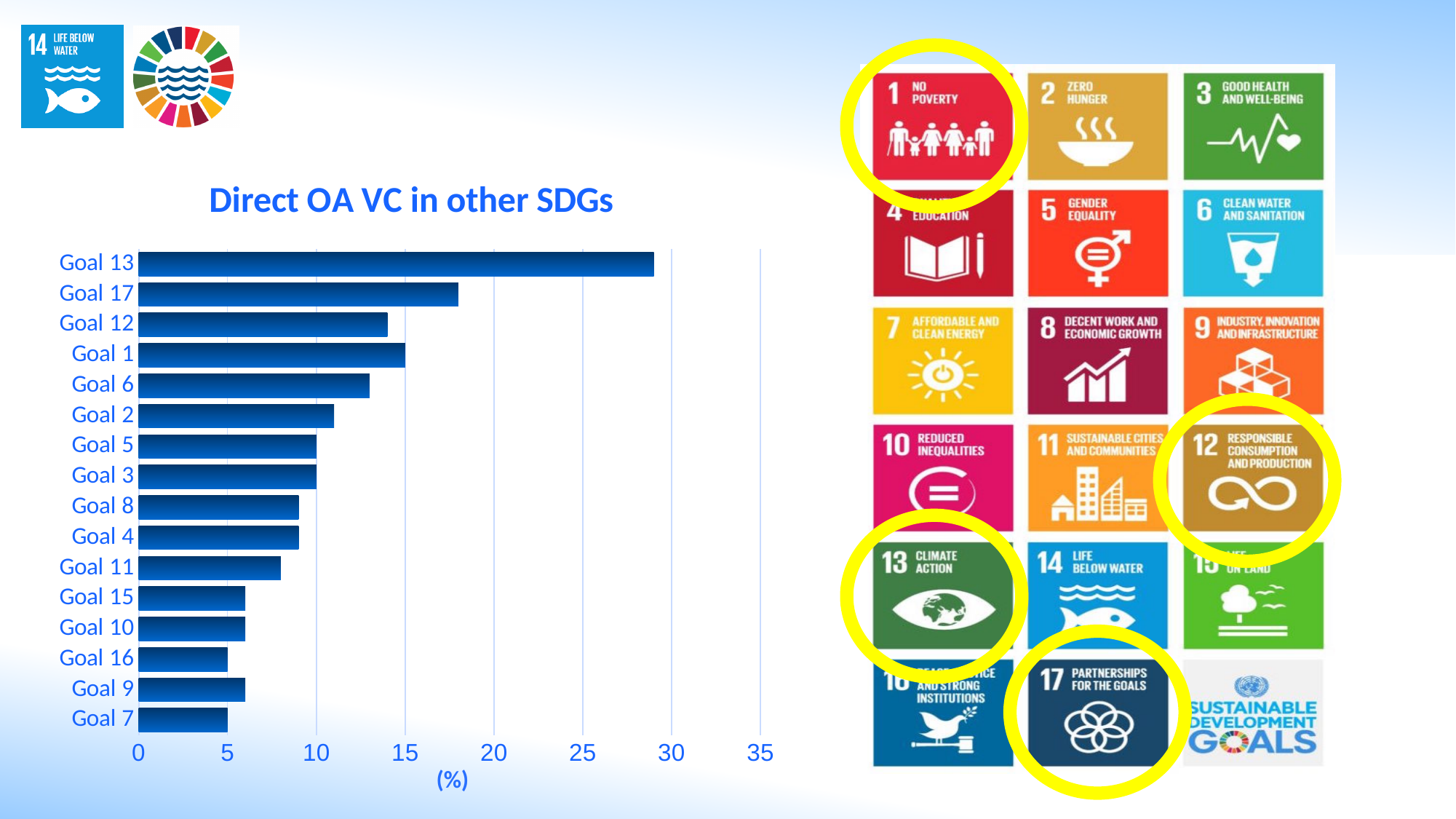
Is the value for Goal 13 greater or less than 25? greater Is the value for Goal 6 greater or less than 10? greater Is the value for Goal 7 greater or less than 10? less How many goals (categories) are plotted in the chart? 16 Which has a larger value, Goal 13 or Goal 17? Goal 13 What is the title of the chart? Direct OA VC in other SDGs Which goal has the highest value in the chart? Goal 13 What type of chart is shown on the slide? bar chart Which has a larger value, Goal 17 or Goal 6? Goal 17 What unit is shown on the horizontal axis label? (%)